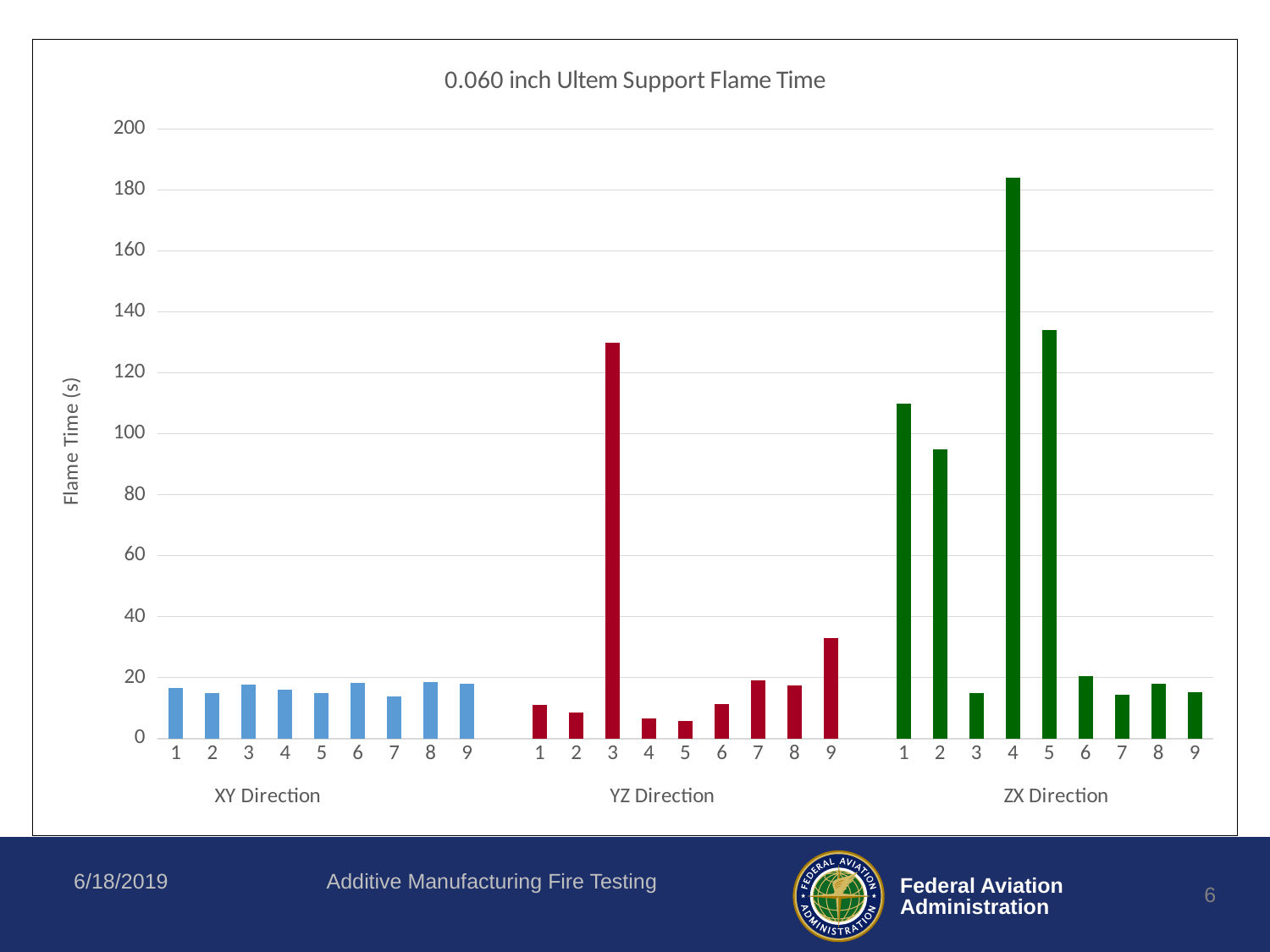
Is the flame time for sample 4 in the ZX Direction greater or less than 160? greater Is the flame time for sample 3 in the YZ Direction greater or less than 120? greater What kind of chart is shown on the slide? bar chart How many samples are plotted in the ZX Direction group? 9 Which direction group contains the tallest bar on the chart? ZX Direction What is the title of the chart? 0.060 inch Ultem Support Flame Time What is the label on the vertical axis of the chart? Flame Time (s) Which sample in the ZX Direction group has the highest flame time? 4 Which is larger, the flame time for sample 5 in the ZX Direction or sample 3 in the YZ Direction? sample 5 in the ZX Direction Is the flame time for sample 1 in the ZX Direction greater or less than 100? greater Which sample in the YZ Direction group has the highest flame time? 3 How many direction groups are shown along the x axis? 3